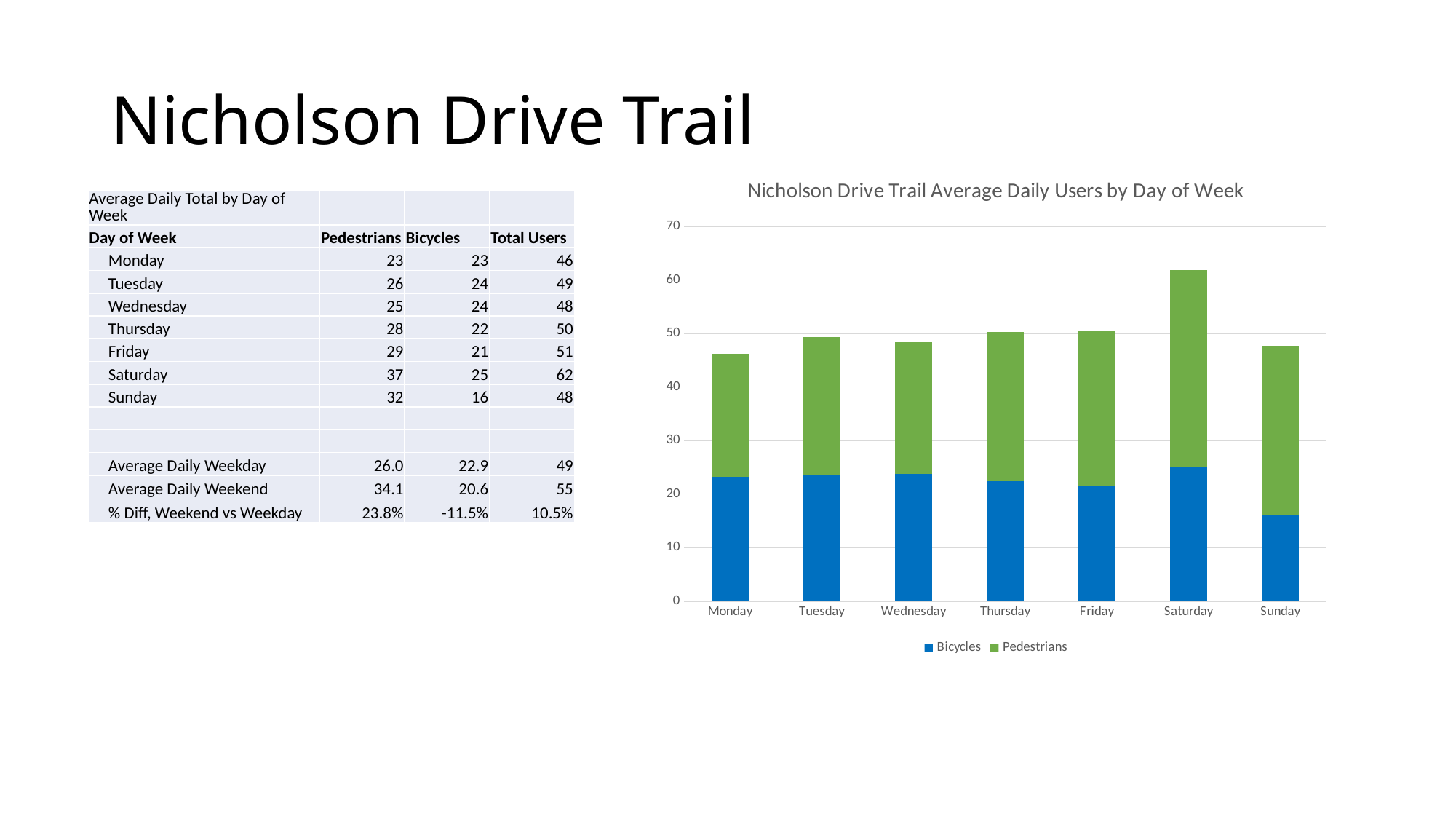
Which is larger in the chart, the Bicycles value for Monday or the Bicycles value for Sunday? Monday What kind of chart is shown on the slide? Stacked bar chart Is the total stacked bar for Monday greater or less than 50? less How many days of the week are shown on the x axis of the chart? 7 What is the title of the chart? Nicholson Drive Trail Average Daily Users by Day of Week Which day has the lowest Bicycles value in the chart? Sunday Is the Bicycles value for Sunday greater or less than 20? less Which day has the highest Pedestrians value in the chart? Saturday Which colour represents Pedestrians in the chart? Green How many series does the chart legend list? 2 Which day has the highest total stacked bar in the chart? Saturday Is the total stacked bar for Saturday greater or less than 60? greater